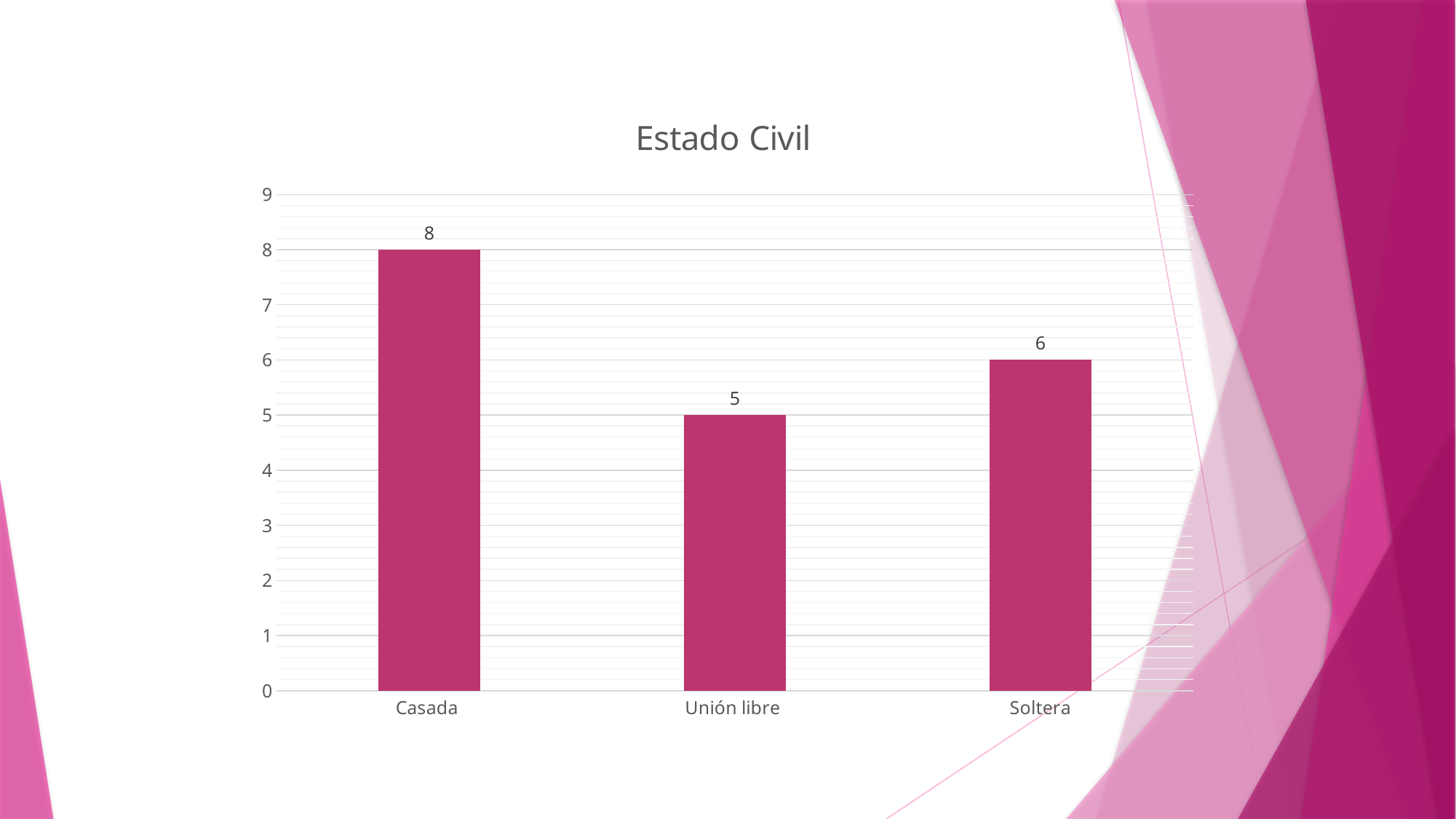
Is the value for Casada greater or less than 7? greater What is the value for Soltera? 6 How many categories are shown on the x axis? 3 What is the difference between the values for Soltera and Unión libre? 1 What is the title of the chart? Estado Civil What kind of chart is shown on the slide? Bar chart What is the difference between the values for Casada and Unión libre? 3 Which is larger, the value for Casada or the value for Soltera? Casada What is the value for Unión libre? 5 What is the value for Casada? 8 Which category has the lowest value? Unión libre Which category has the highest value? Casada